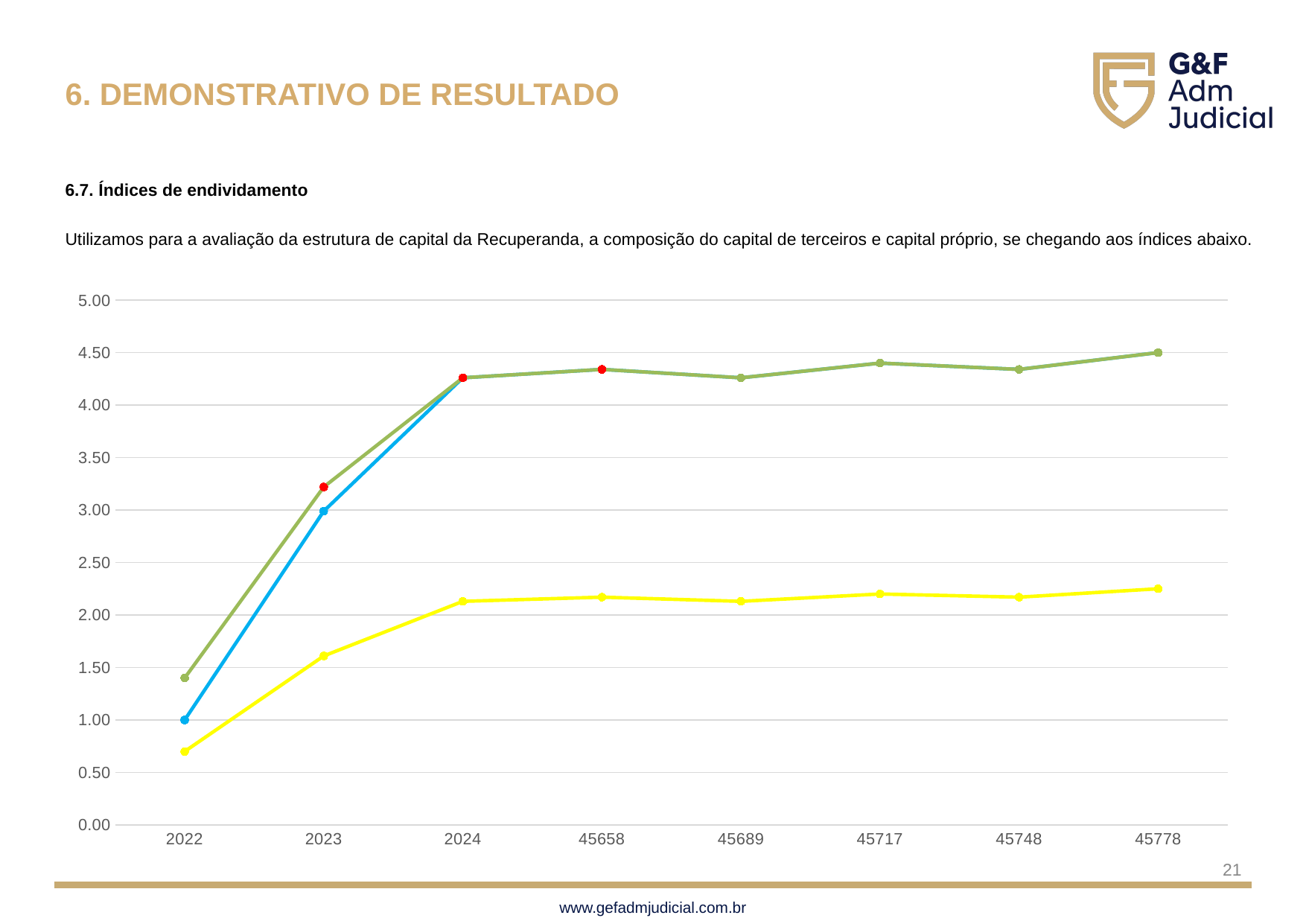
At which x-axis category does the yellow line reach its lowest value? 2022 At 2023, which line has the larger value, the green line or the blue line? green line At 2022, which line has the larger value, the green line or the yellow line? green line Is the value of the yellow line at 45778 greater or less than 2.00? greater Is the value of the green line at 2022 greater or less than 1.00? greater Is the value of the yellow line at 2022 greater or less than 1.00? less What is the first label on the x axis of the chart? 2022 What kind of chart is shown on the slide? line chart How many categories are shown on the x axis of the chart? 8 Does the yellow line rise or fall from 2022 to 2024? rise